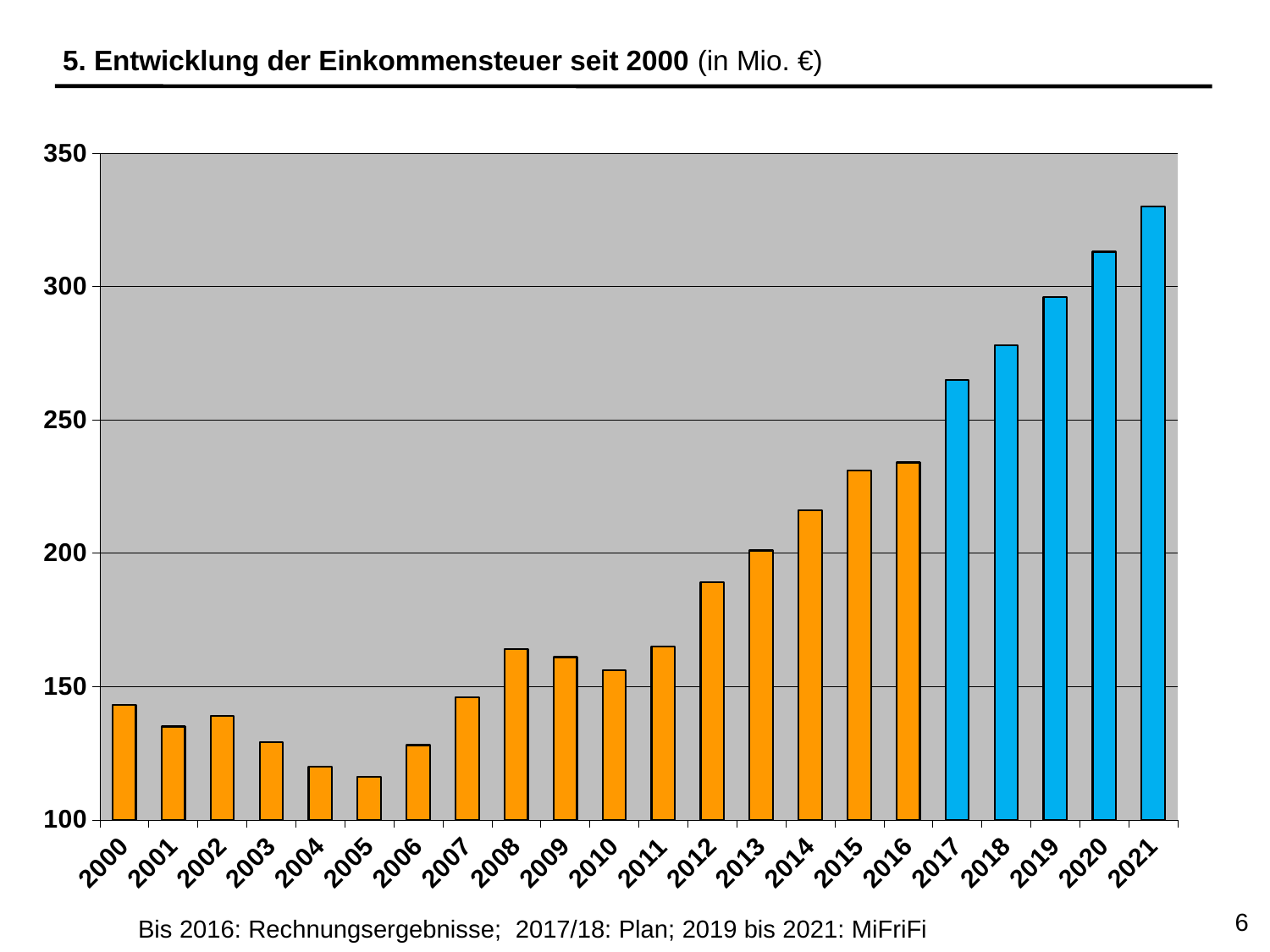
Is the value for 2005 greater or less than 150? less How many years (bars) are shown in the chart? 22 Which year has the lowest value in the chart? 2005 Is the value for 2012 greater or less than 200? less What colour are the bars for the years 2017 to 2021? blue Do the values generally rise or fall from 2005 to 2021? rise Which year has the highest value in the chart? 2021 Is the value for 2020 greater or less than 300? greater What kind of chart is shown on the slide? bar chart Which year has the larger value, 2004 or 2007? 2007 Which year has the larger value, 2000 or 2021? 2021